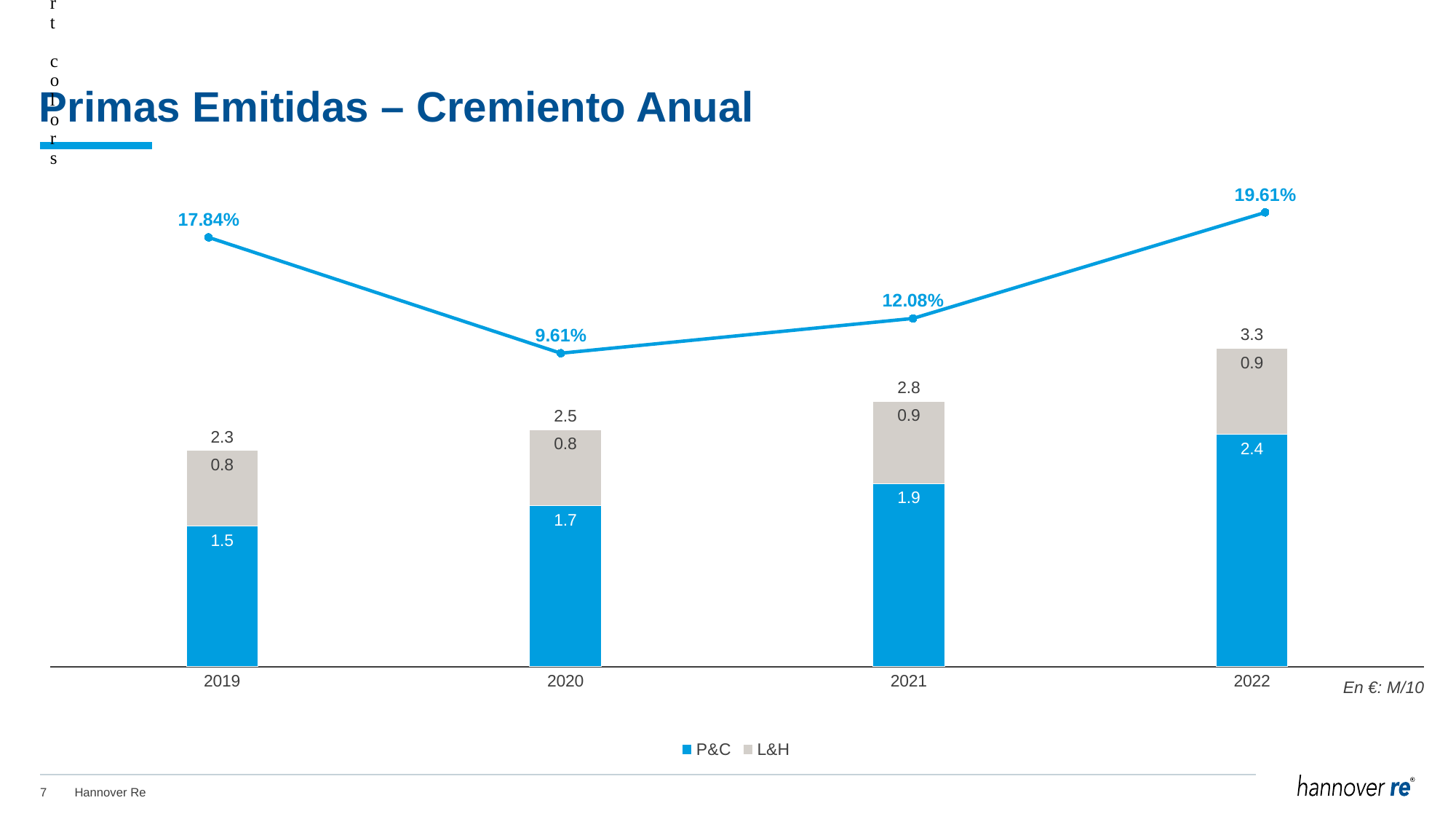
How many years are shown on the x axis? 4 What is the difference between the P&C values for 2022 and 2019? 0.9 What is the P&C value for 2021? 1.9 Which year has the highest growth percentage on the line? 2022 What is the total of the stacked bar for 2022? 3.3 What is the L&H value for 2020? 0.8 Do the stacked bar totals rise or fall from 2019 to 2022? rise Which year has the lowest growth percentage on the line? 2020 What growth percentage is shown on the line for 2020? 9.61% Which is larger, the P&C value for 2020 or the P&C value for 2021? 2021 How many series does the legend list? 2 What is the title of the slide? Primas Emitidas – Cremiento Anual